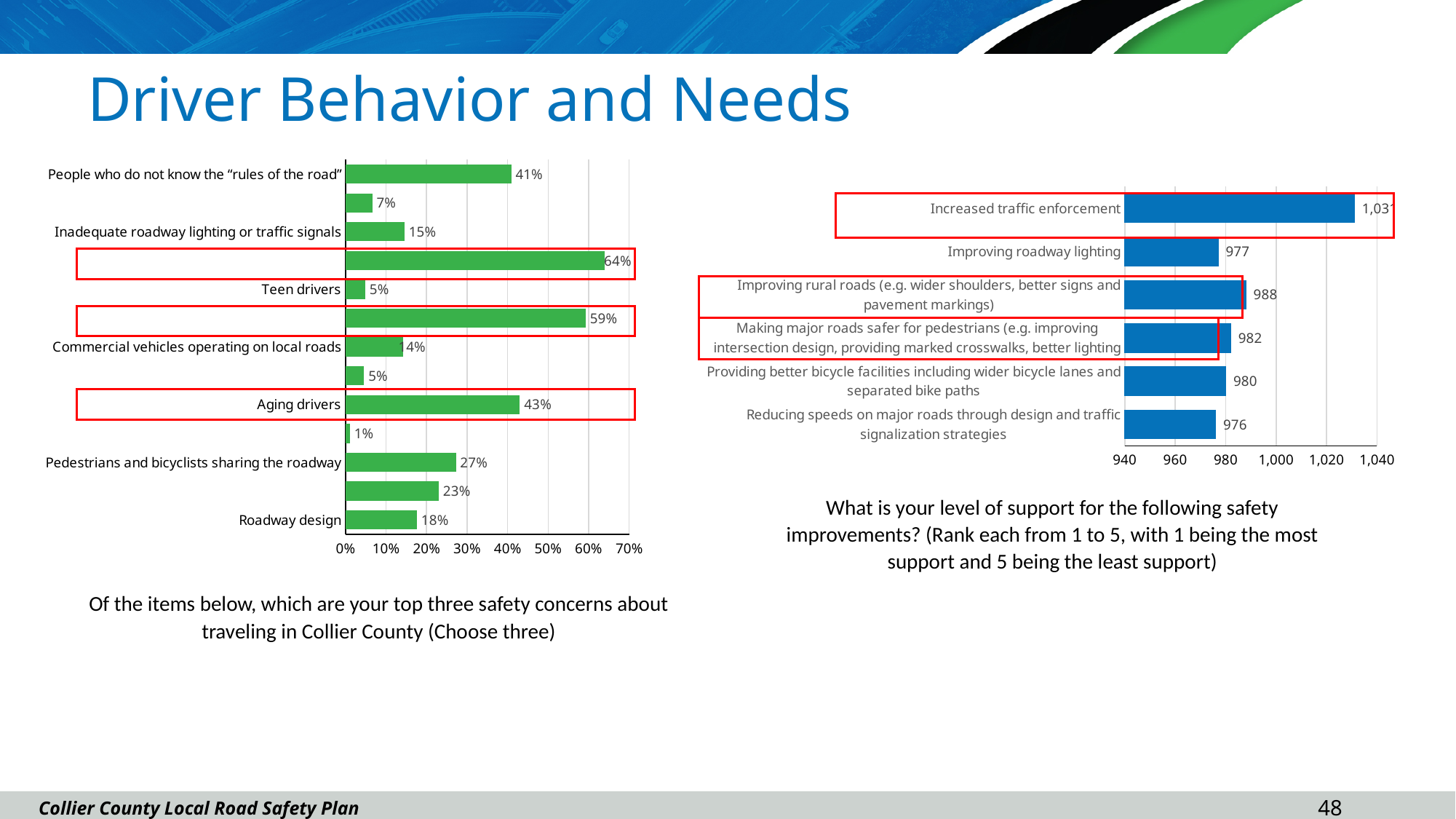
In the right chart on level of support for safety improvements, what is the difference between the values for Improving rural roads and Improving roadway lighting? 11 In the right chart on level of support for safety improvements, which improvement has the highest value? Increased traffic enforcement What kind of chart is the left chart on top three safety concerns? Bar chart In the left chart on top three safety concerns, what is the difference between the values for Aging drivers and Roadway design? 25% In the right chart on level of support for safety improvements, what value is shown for Reducing speeds on major roads through design and traffic signalization strategies? 976 In the right chart on level of support for safety improvements, what value is shown for Improving rural roads (e.g. wider shoulders, better signs and pavement markings)? 988 In the left chart on top three safety concerns, what percentage is shown for Roadway design? 18% In the left chart on top three safety concerns, what percentage is shown for Teen drivers? 5% In the left chart on top three safety concerns, what percentage is shown for Pedestrians and bicyclists sharing the roadway? 27% In the left chart on top three safety concerns, what percentage is shown for Aging drivers? 43% How many safety improvements are listed in the right chart on level of support? 6 In the right chart on level of support for safety improvements, which improvement has the lowest value? Reducing speeds on major roads through design and traffic signalization strategies